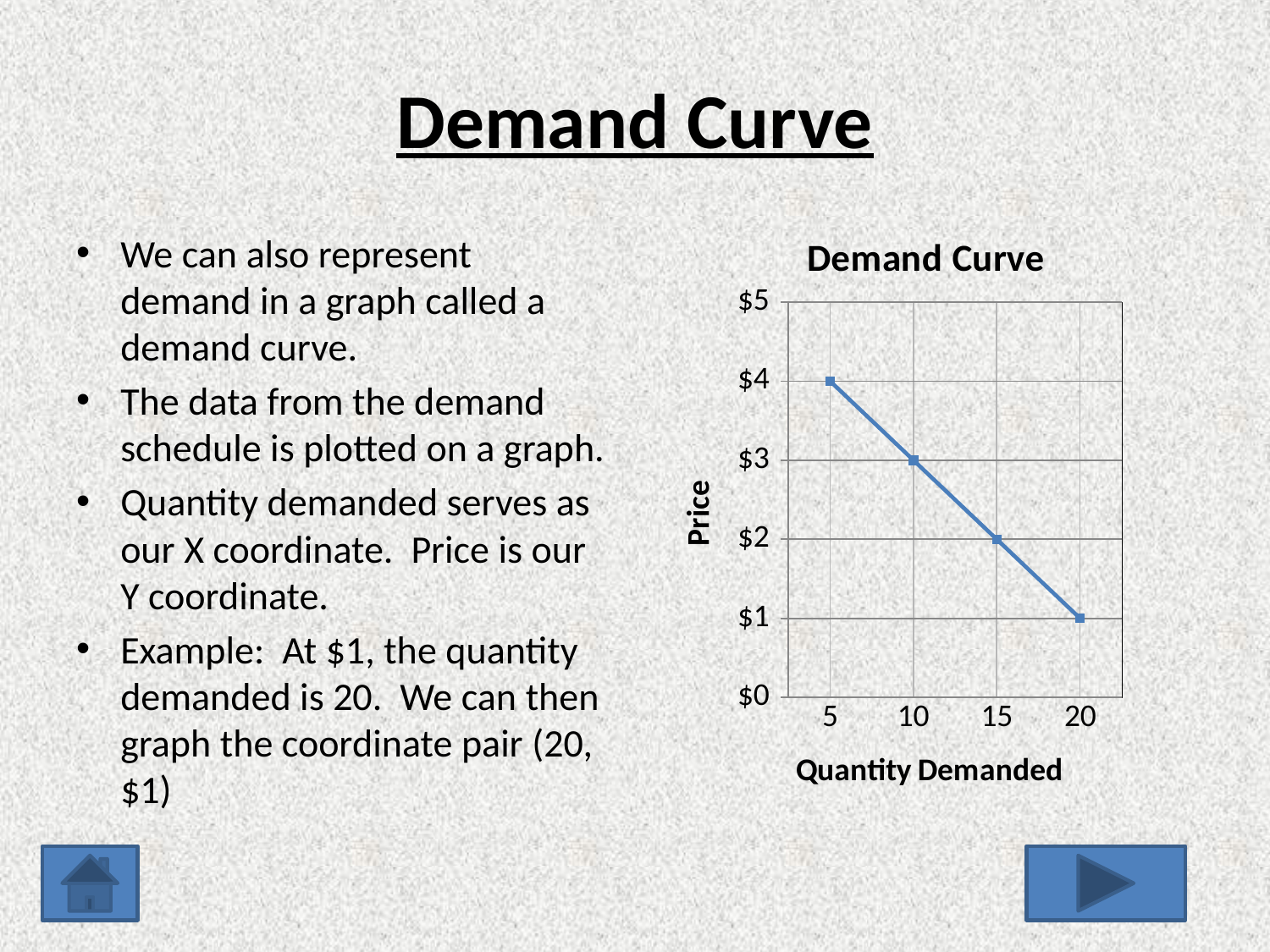
What is the title of the chart? Demand Curve What type of chart is shown on the slide? line chart What is the price when the quantity demanded is 5? $4 Which has a higher price: a quantity demanded of 10 or a quantity demanded of 15? 10 How many data points are plotted on the chart? 4 What is the difference in price between a quantity demanded of 5 and a quantity demanded of 20? $3 What is the price when the quantity demanded is 15? $2 At which quantity demanded is the price lowest? 20 What is the price when the quantity demanded is 10? $3 At which quantity demanded is the price highest? 5 Does the price rise or fall as quantity demanded increases along the x axis? fall What is the price when the quantity demanded is 20? $1